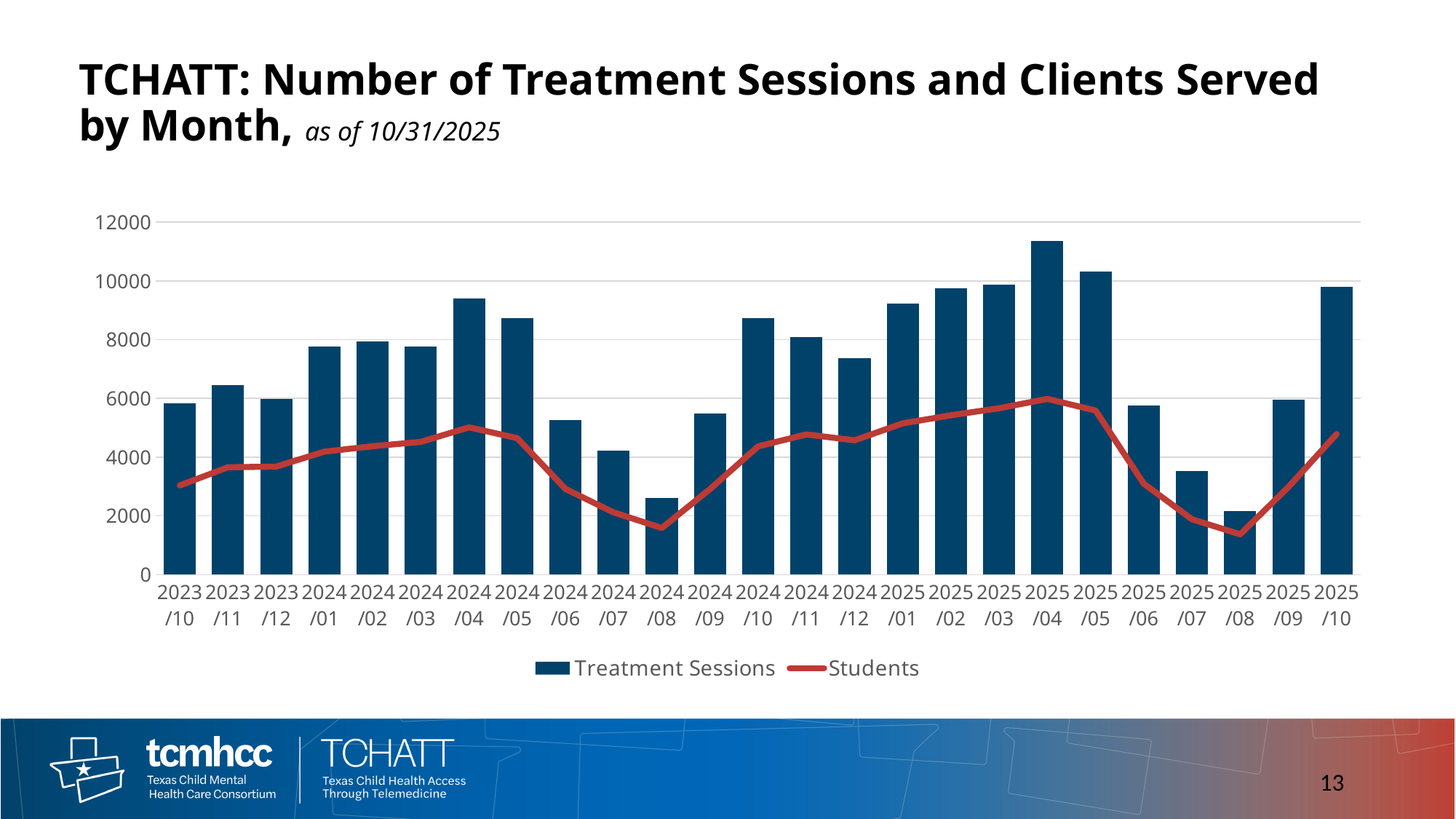
What colour represents the Students series in the legend? Red How many series does the legend list? 2 Which month has more Treatment Sessions, 2025/04 or 2025/05? 2025/04 What kind of chart is shown on the slide? A combined bar and line chart Is the Treatment Sessions value for 2024/08 greater or less than 4000? less Do Treatment Sessions rise or fall from 2025/05 to 2025/08? fall Which month has the lowest value on the Students line? 2025/08 Which month has the lowest number of Treatment Sessions? 2025/08 Is the Students value for 2024/08 greater or less than 2000? less How many months are plotted along the x axis? 25 Which month has the highest number of Treatment Sessions? 2025/04 Is the Treatment Sessions value for 2025/04 greater or less than 10000? greater